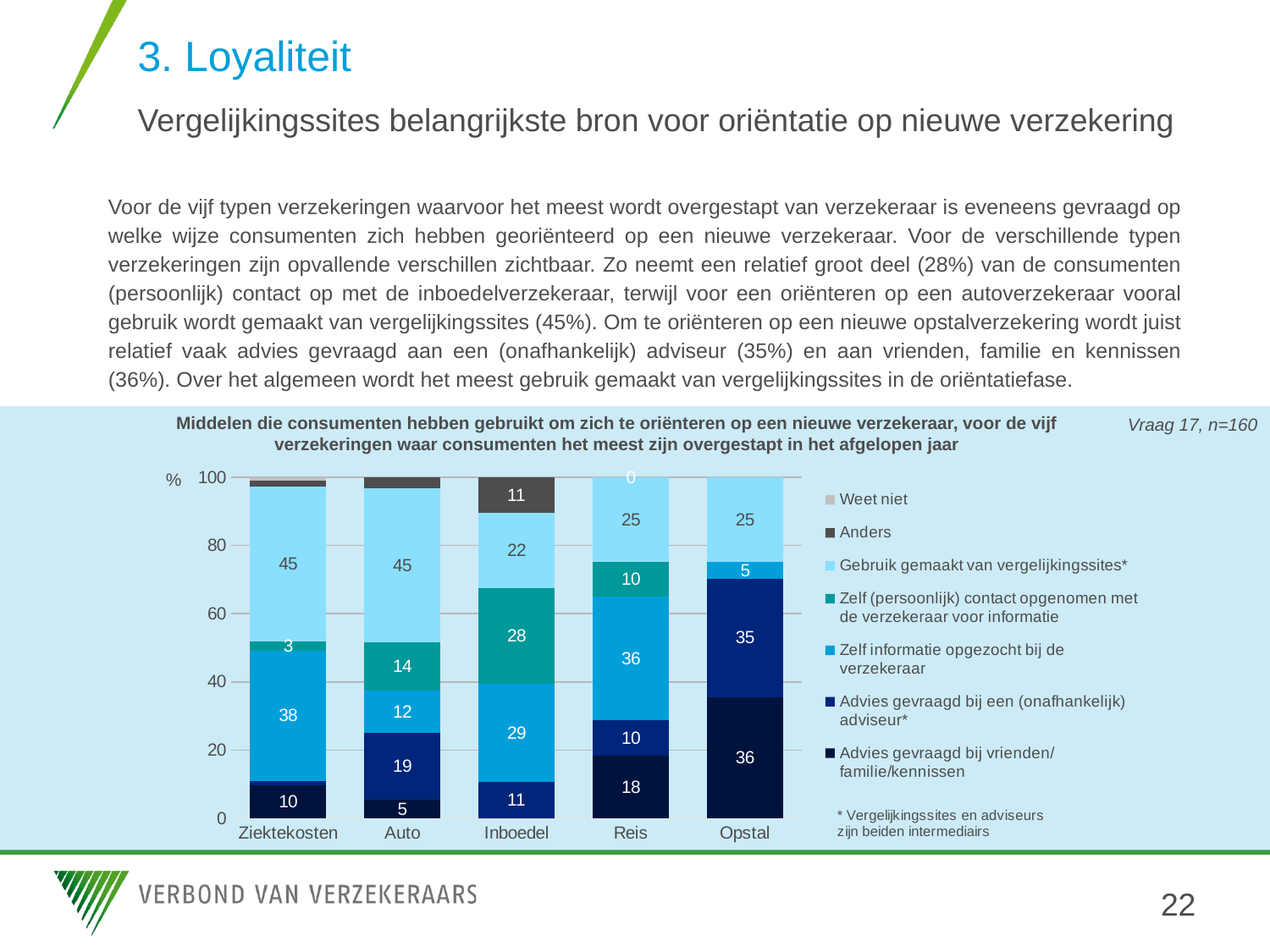
How many series does the chart's legend list? 7 How many insurance types (categories) are shown on the x axis of the chart? 5 What is the value for 'Advies gevraagd bij vrienden/familie/kennissen' for Opstal? 36 What question number and sample size are noted at the top right of the chart? Vraag 17, n=160 What type of chart is shown on the slide? Stacked bar chart What is the difference between the 'Gebruik gemaakt van vergelijkingssites*' values for Auto and Inboedel? 23 What is the value for 'Zelf (persoonlijk) contact opgenomen met de verzekeraar voor informatie' for Inboedel? 28 Which has a larger value for 'Gebruik gemaakt van vergelijkingssites*': Inboedel or Reis? Reis What is the value for 'Advies gevraagd bij een (onafhankelijk) adviseur*' for Opstal? 35 What is the value for 'Gebruik gemaakt van vergelijkingssites*' for Auto? 45 Which insurance type has the lowest value for 'Gebruik gemaakt van vergelijkingssites*'? Inboedel What is the value for 'Zelf informatie opgezocht bij de verzekeraar' for Reis? 36